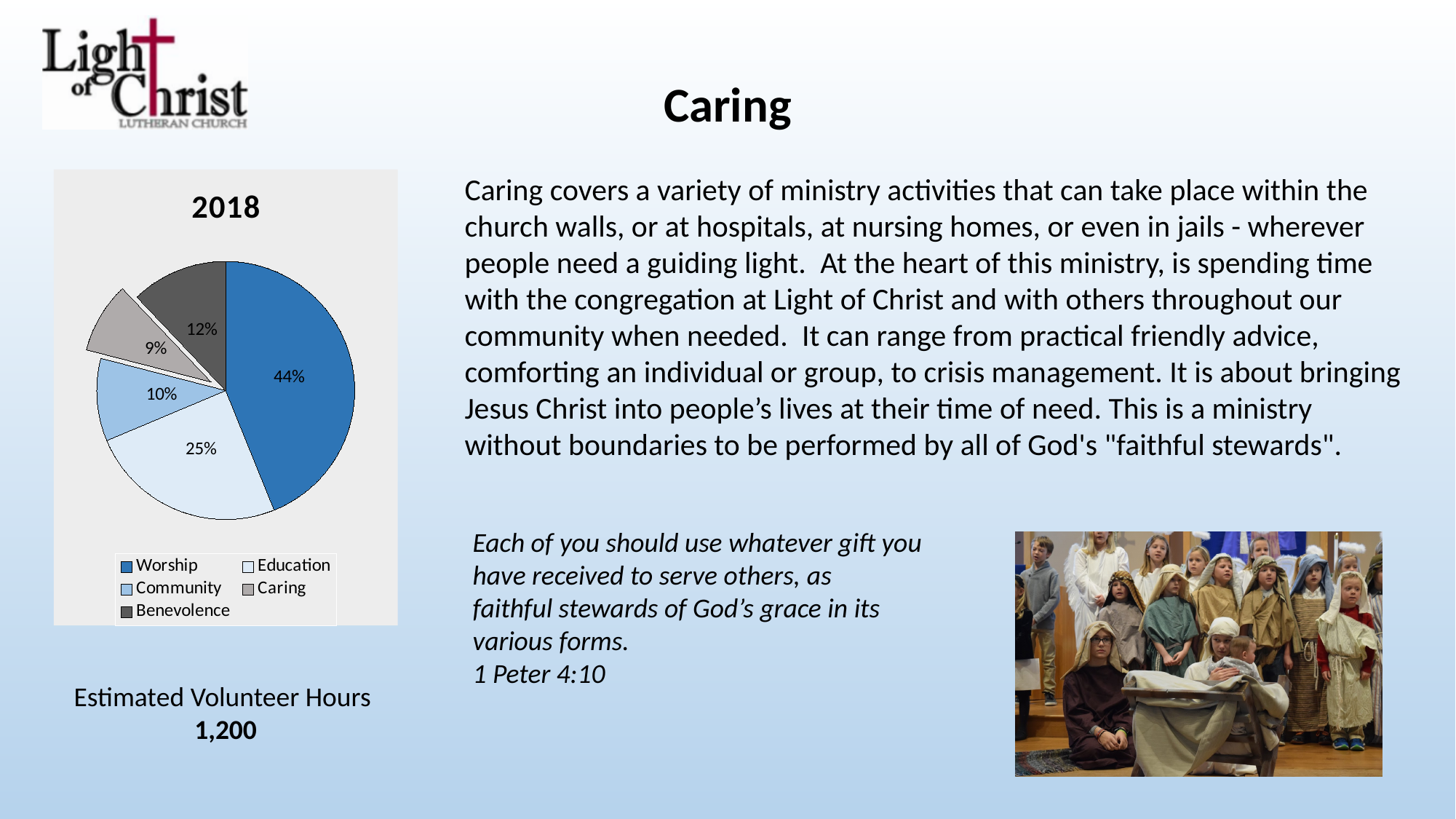
What share of the pie does Benevolence have? 12% What share of the pie does Worship have? 44% What is the title of the pie chart? 2018 Which is larger, the Benevolence slice or the Community slice? Benevolence Which category has the largest slice of the pie? Worship What share of the pie does Community have? 10% What is the difference in percentage points between Worship and Education? 19 How many categories does the pie chart show? 5 What kind of chart is shown on the slide? Pie chart Which category has the smallest slice of the pie? Caring